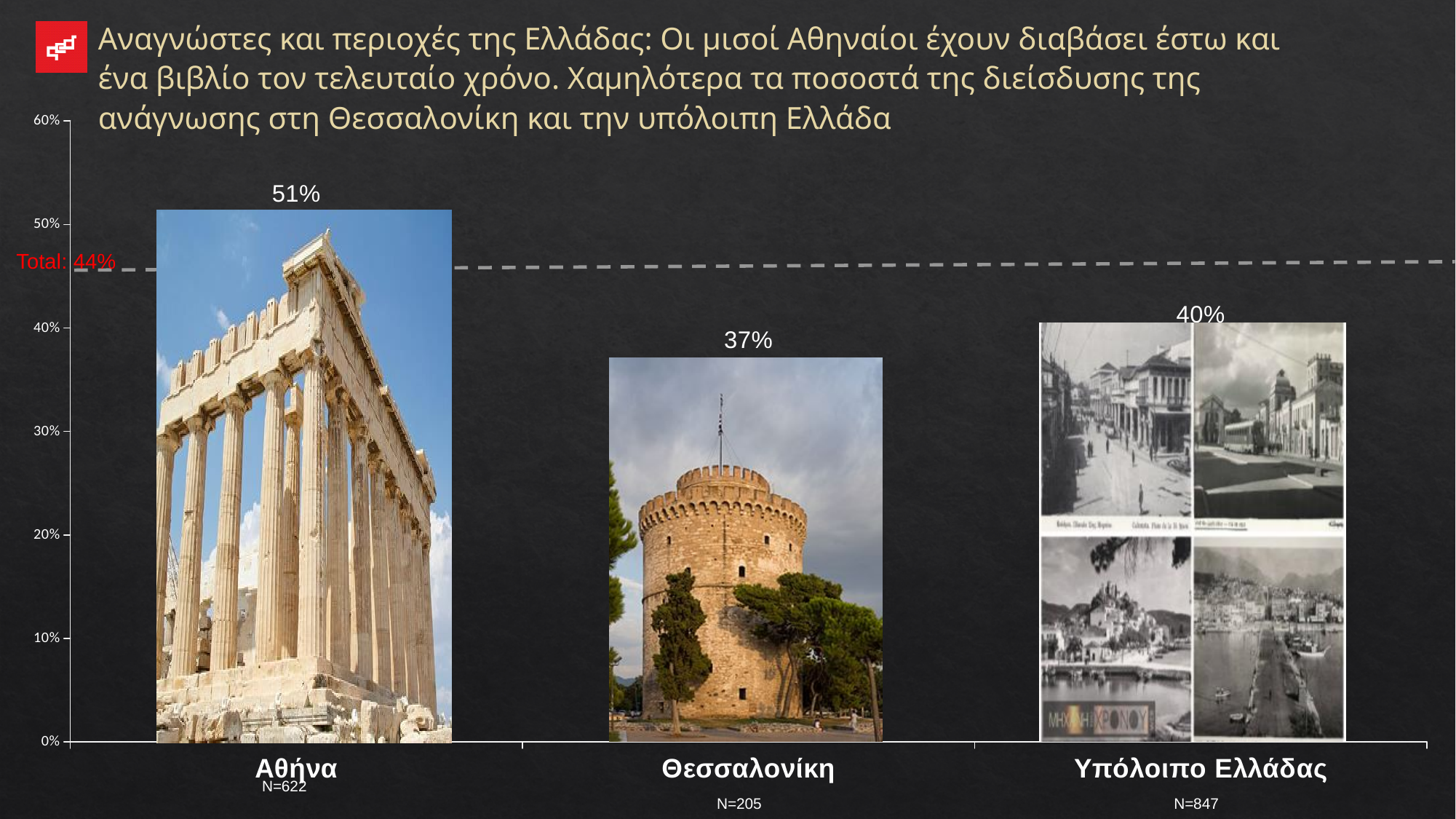
What total value is marked by the dashed line on the chart? 44% Which category has the lowest value? Θεσσαλονίκη What is the difference between the values for Υπόλοιπο Ελλάδας and Θεσσαλονίκη? 3% What is the value for Αθήνα? 51% What is the value for Θεσσαλονίκη? 37% What is the difference between the values for Αθήνα and Θεσσαλονίκη? 14% What is the value for Υπόλοιπο Ελλάδας? 40% How many categories are shown on the chart? 3 Which is larger, the value for Αθήνα or the value for Υπόλοιπο Ελλάδας? Αθήνα What kind of chart is shown on the slide? bar chart Which category has the highest value? Αθήνα Is the value for Θεσσαλονίκη greater or less than 40%? less